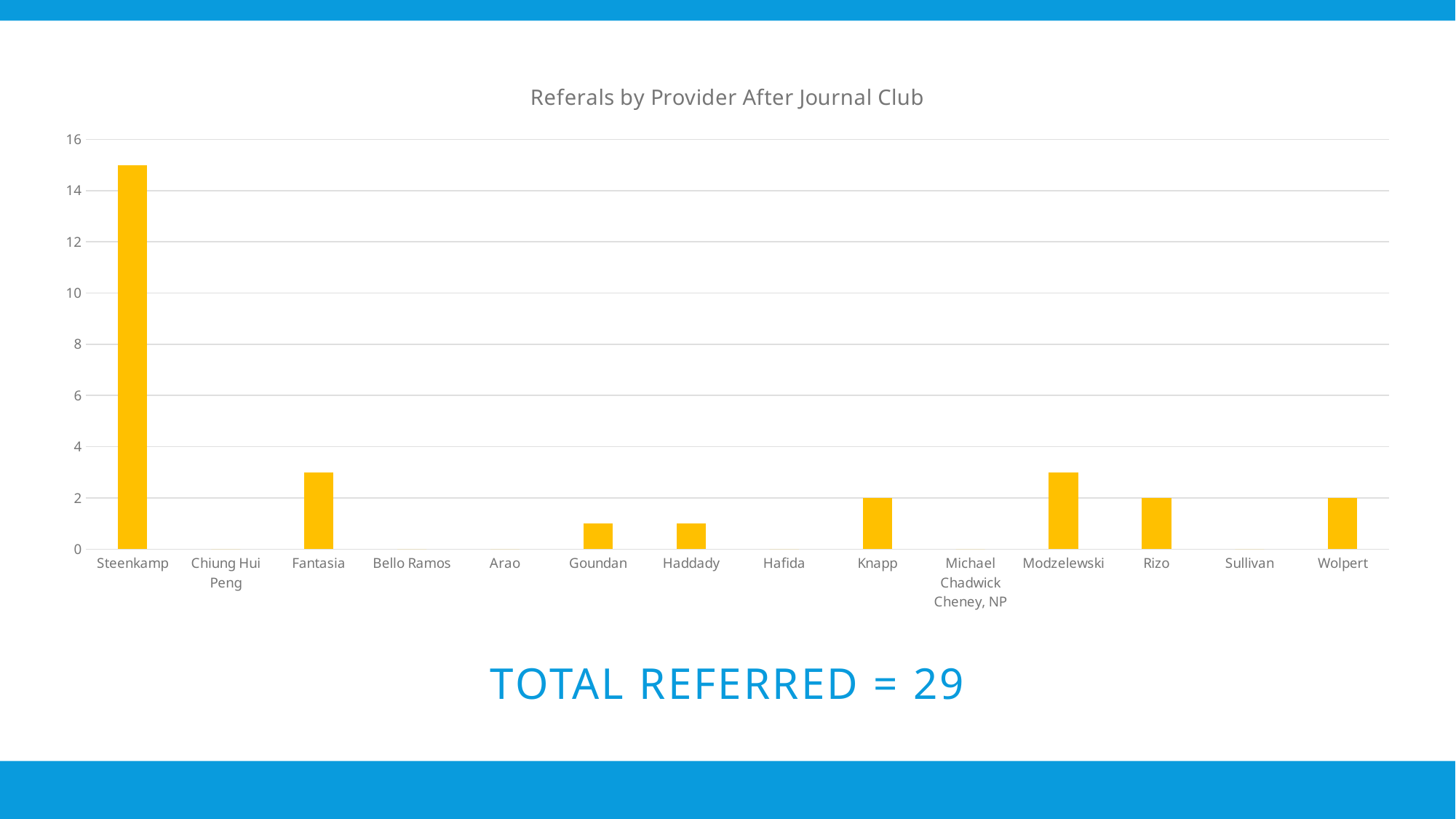
What is the title of the chart? Referals by Provider After Journal Club What is the difference between the value for Rizo and the value for Hafida? 2 What is the value for Wolpert? 2 Is the value for Fantasia greater or less than 4? less Which is larger, the value for Steenkamp or the value for Modzelewski? Steenkamp Which provider has the highest number of referrals? Steenkamp What is the value for Sullivan? 0 How many providers are shown on the x axis of the chart? 14 Is the value for Goundan greater or less than 2? less What is the value for Knapp? 2 What kind of chart is shown on the slide? bar chart Is the value for Steenkamp greater or less than 14? greater